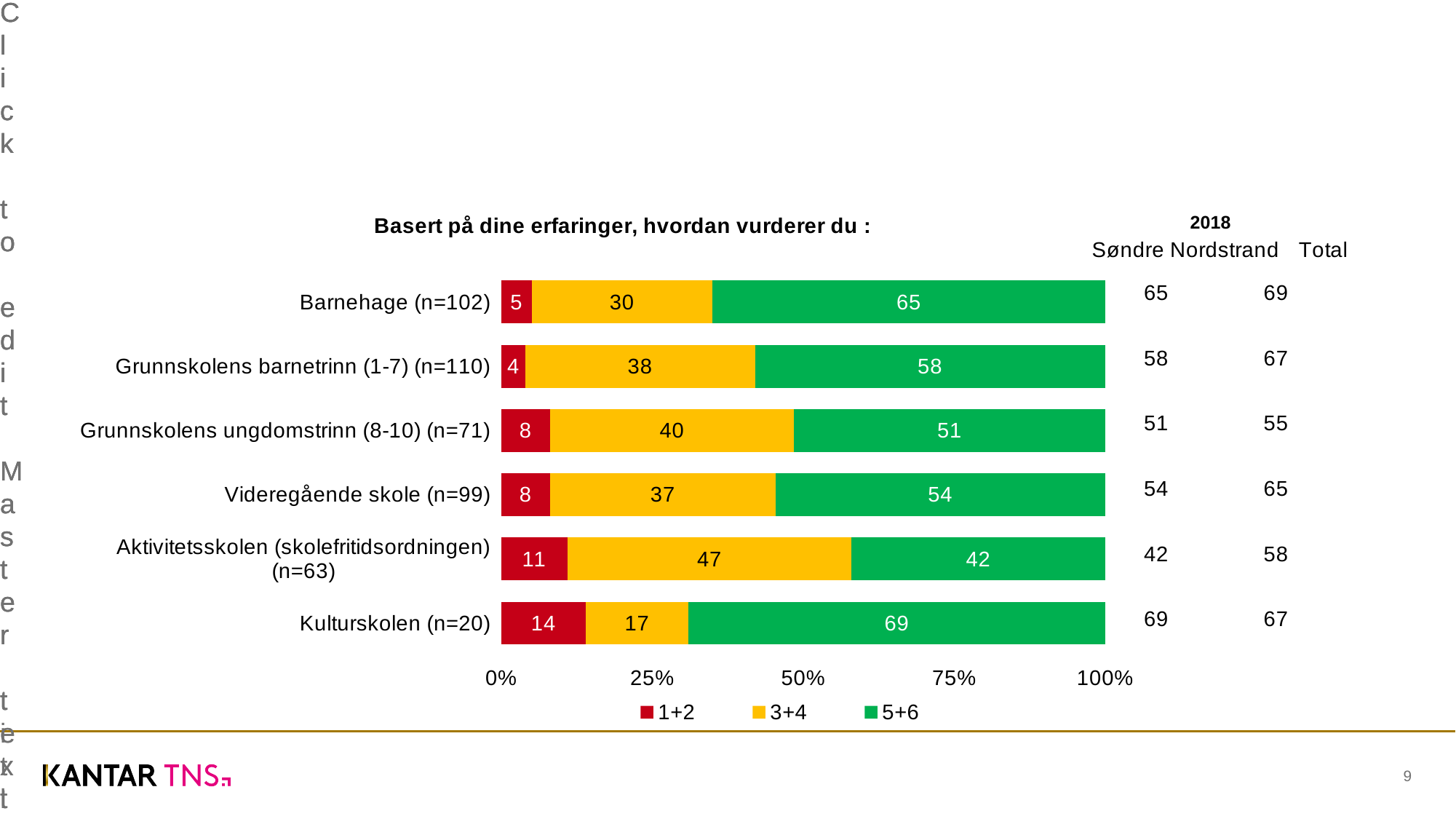
How many categories are shown in the chart? 6 What are the legend entries of the chart? 1+2, 3+4, 5+6 Which category has the lowest value for the 5+6 series? Aktivitetsskolen (skolefritidsordningen) (n=63) What is the total of the stacked bar for Kulturskolen (n=20)? 100 What is the value of the 5+6 series for Barnehage (n=102)? 65 How many series does the legend list? 3 Which category has the highest value for the 1+2 series? Kulturskolen (n=20) What is the value of the 1+2 series for Grunnskolens barnetrinn (1-7) (n=110)? 4 What kind of chart is shown on the slide? Stacked bar chart What is the difference between the 5+6 values for Kulturskolen (n=20) and Barnehage (n=102)? 4 Which has the larger 3+4 value: Grunnskolens ungdomstrinn (8-10) (n=71) or Videregående skole (n=99)? Grunnskolens ungdomstrinn (8-10) (n=71) What is the value of the 3+4 series for Aktivitetsskolen (skolefritidsordningen) (n=63)? 47